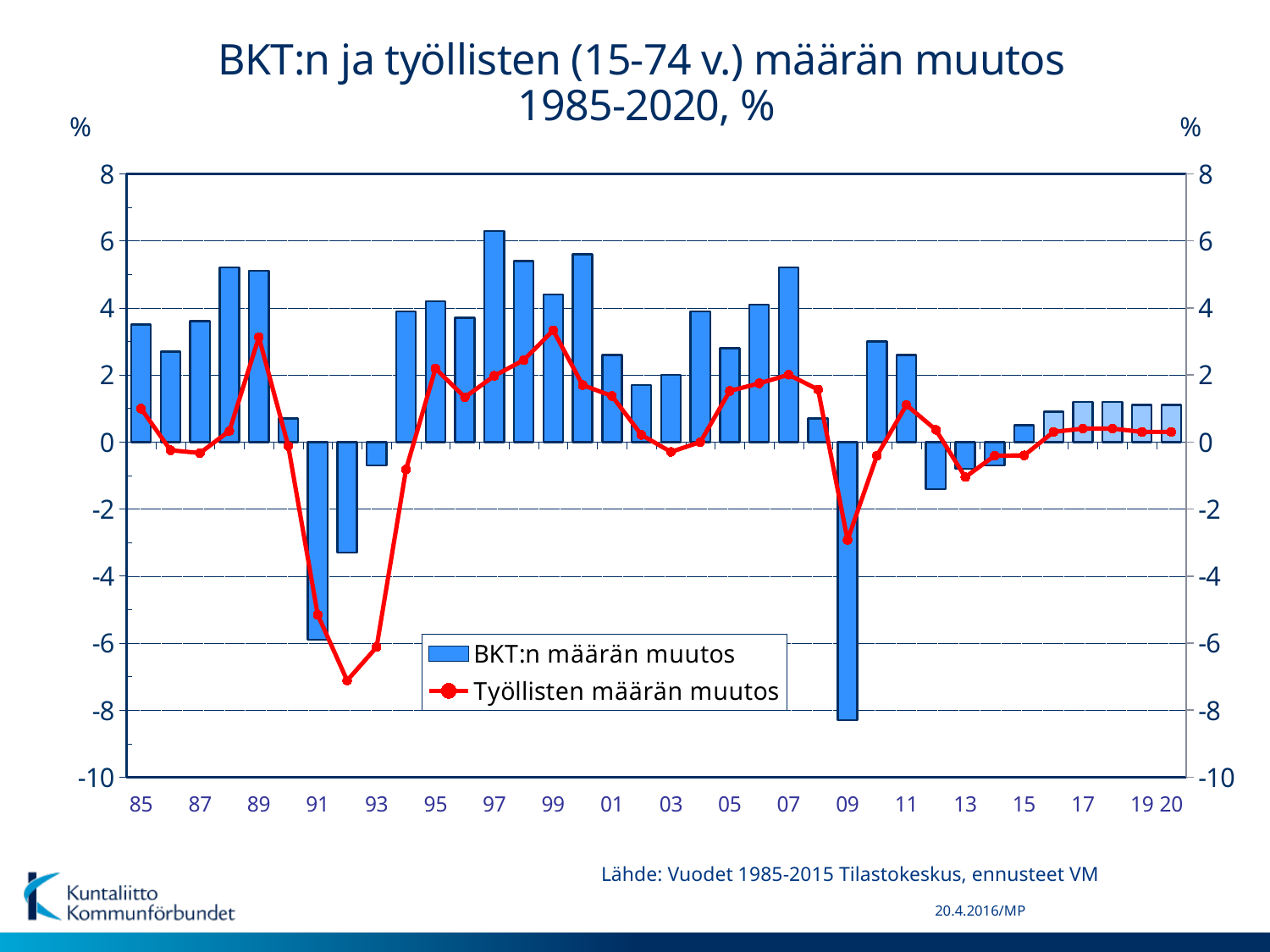
Is the BKT:n määrän muutos value for 1997 greater or less than 4? greater What kind of chart is shown on the slide? A bar chart combined with a line chart How many series does the legend list? 2 Is the BKT:n määrän muutos value for 2009 greater or less than -6? less How many years (bars) are plotted on the chart? 36 In which year does the Työllisten määrän muutos line reach its lowest point? 1992 In which year is the bar for BKT:n määrän muutos lowest? 2009 Which series is drawn as a red line with markers? Työllisten määrän muutos Which year has the larger BKT:n määrän muutos bar, 1988 or 1990? 1988 Is the Työllisten määrän muutos value for 2009 greater or less than -2? less In which year is the bar for BKT:n määrän muutos highest? 1997